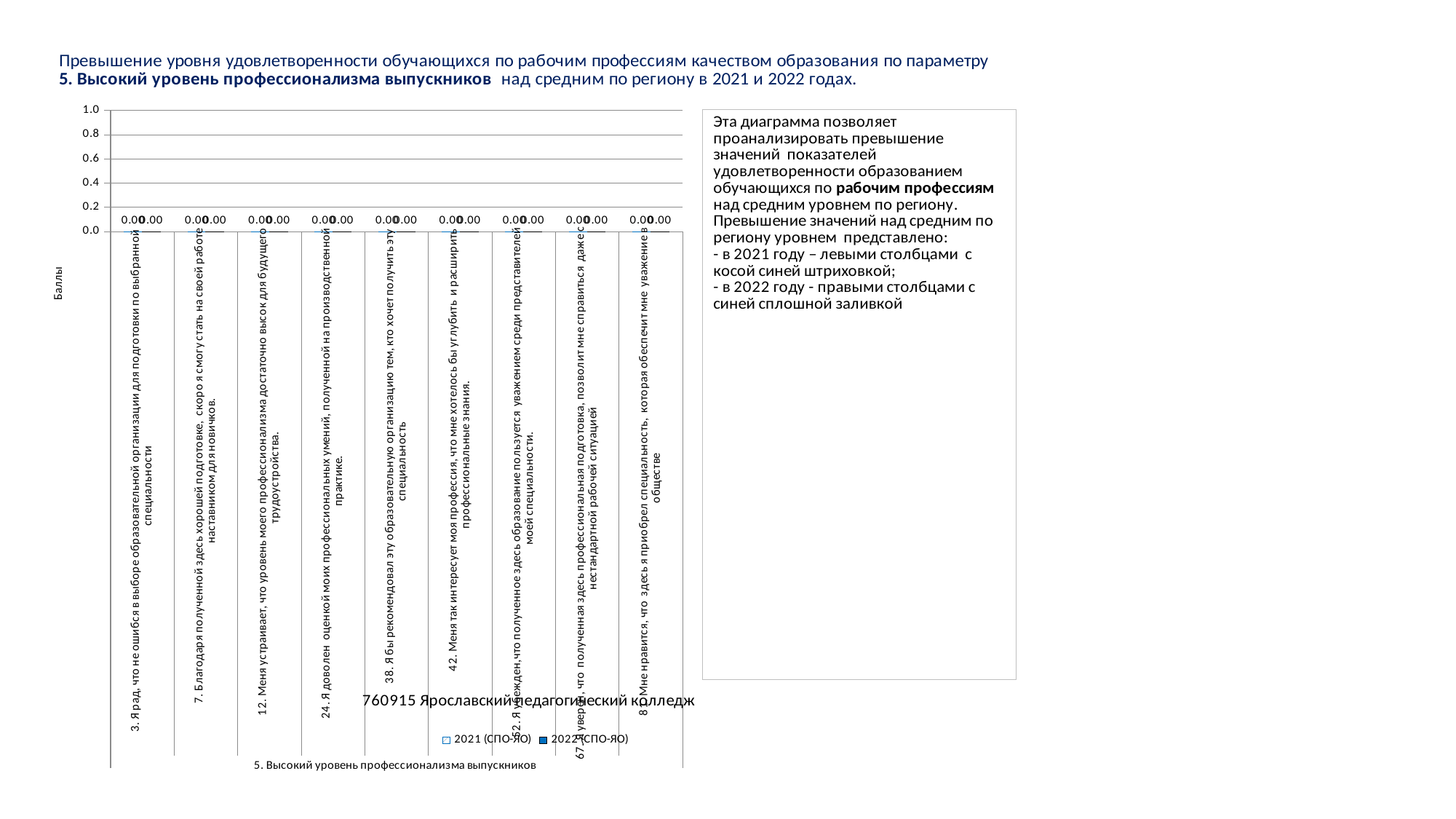
What is the value for 2022 (СПО-ЯО) for the category "12. Меня устраивает, что уровень моего профессионализма достаточно высок для будущего трудоустройства"? 0.00 How many series does the chart legend list? 2 What is the value for 2021 (СПО-ЯО) for the category "3. Я рад, что не ошибся в выборе образовательной организации для подготовки по выбранной специальности"? 0.00 Is the value for 2021 (СПО-ЯО) for the category "42. Меня так интересует моя профессия, что мне хотелось бы углубить и расширить профессиональные знания" greater or less than 0.2? less What is the value for 2021 (СПО-ЯО) for the category "38. Я бы рекомендовал эту образовательную организацию тем, кто хочет получить эту специальность"? 0.00 What are the two series named in the chart legend? 2021 (СПО-ЯО) and 2022 (СПО-ЯО) What is the difference between the 2021 (СПО-ЯО) and 2022 (СПО-ЯО) values for the category "24. Я доволен оценкой моих профессиональных умений, полученной на производственной практике"? 0.00 What is the highest value shown on the vertical axis of the chart? 1.0 What kind of chart is shown on the slide? bar chart What is the label of the vertical axis of the chart? Баллы What is the value for 2022 (СПО-ЯО) for the category "67. Я уверен, что полученная здесь профессиональная подготовка, позволит мне справиться даже с нестандартной рабочей ситуацией"? 0.00 How many categories are shown on the x axis of the chart? 9